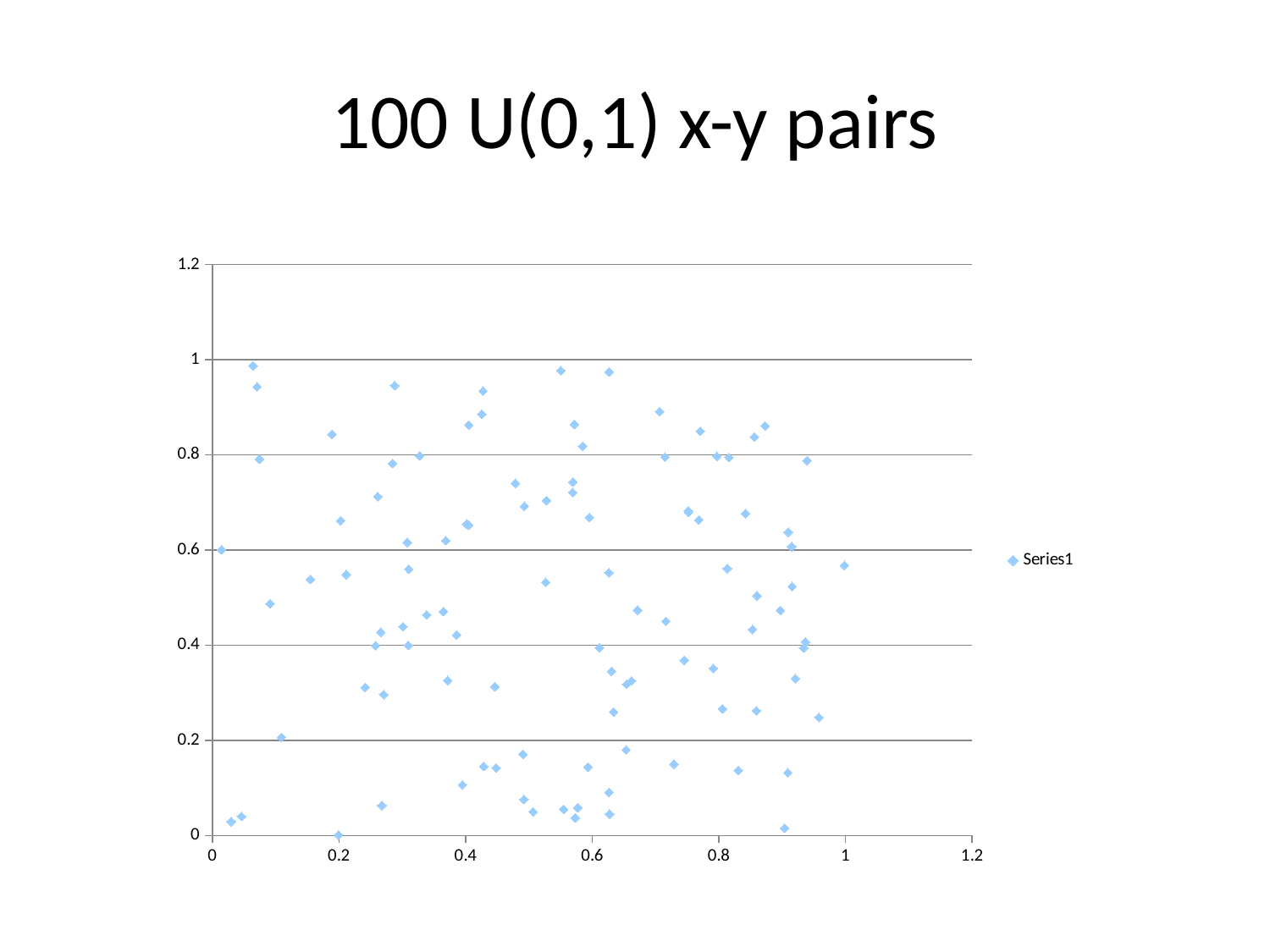
Are any points plotted with an x value greater than 1.2? no How many x-y pairs does the chart title say are plotted? 100 What kind of chart is shown on the slide? scatter chart What is the title of the chart? 100 U(0,1) x-y pairs What is the name of the series shown in the legend? Series1 Is the y value of the point plotted at x = 0 greater or less than 0.8? less Is the y value of the point plotted at x = 0 greater or less than 0.4? greater What is the highest tick value shown on the x axis? 1.2 How many series does the legend list? 1 What is the highest tick value shown on the y axis? 1.2